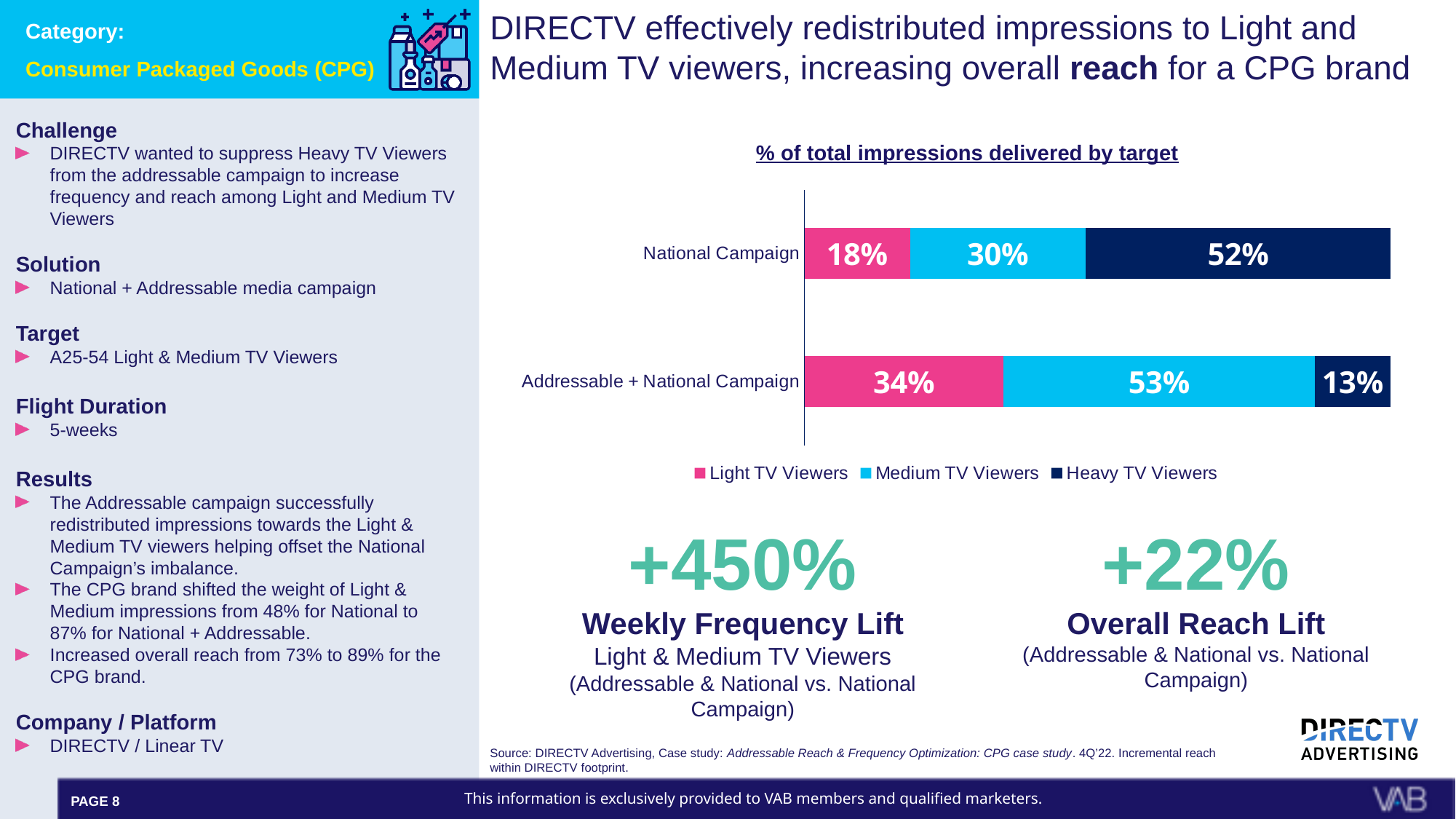
How many series does the legend list? 3 What percentage of total impressions did the National Campaign deliver to Light TV Viewers? 18% What is the difference in the Heavy TV Viewers share between the National Campaign and the Addressable + National Campaign? 39 percentage points Which campaign delivered a larger share of impressions to Medium TV Viewers? Addressable + National Campaign What percentage of total impressions did the National Campaign deliver to Heavy TV Viewers? 52% What percentage of total impressions did the Addressable + National Campaign deliver to Light TV Viewers? 34% What is the title of the chart? % of total impressions delivered by target How many campaigns (bars) are shown in the chart? 2 Which viewer segment received the largest share of impressions in the National Campaign? Heavy TV Viewers What percentage of total impressions did the Addressable + National Campaign deliver to Medium TV Viewers? 53% What type of chart is used to show the % of total impressions delivered by target? Stacked bar chart Which viewer segment received the smallest share of impressions in the Addressable + National Campaign? Heavy TV Viewers